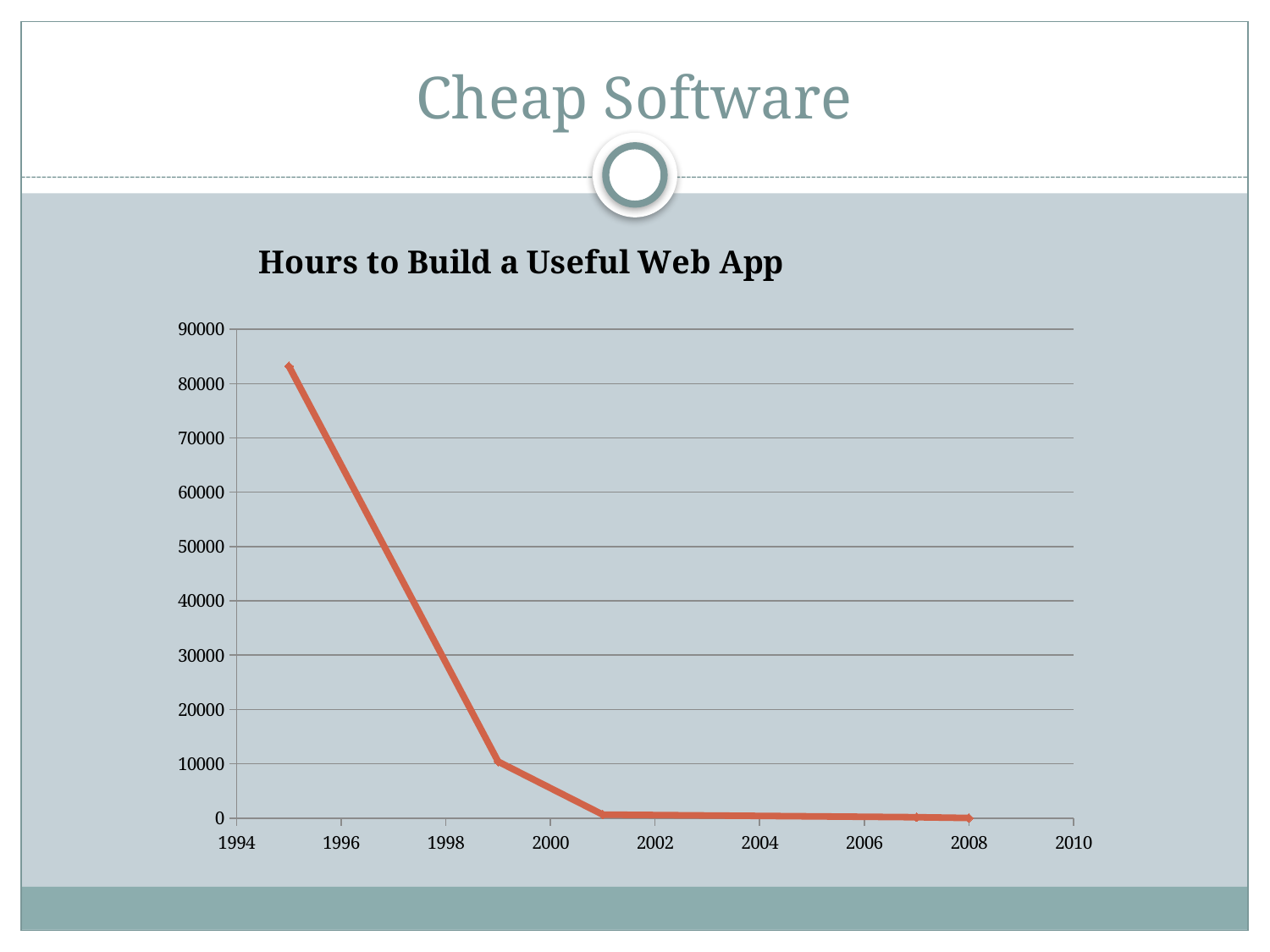
What kind of chart is shown on the slide? line chart Is the value for 2001 greater or less than 10000? less Do the values rise or fall as the years increase along the x axis? fall Which is larger, the value for 1999 or the value for 2008? 1999 What is the title of the chart? Hours to Build a Useful Web App Which is larger, the value for 1995 or the value for 1999? 1995 Which year has the highest value on the chart? 1995 Is the value for 1999 greater or less than 20000? less What is the highest value shown on the vertical axis? 90000 Is the value for 1995 greater or less than 80000? greater